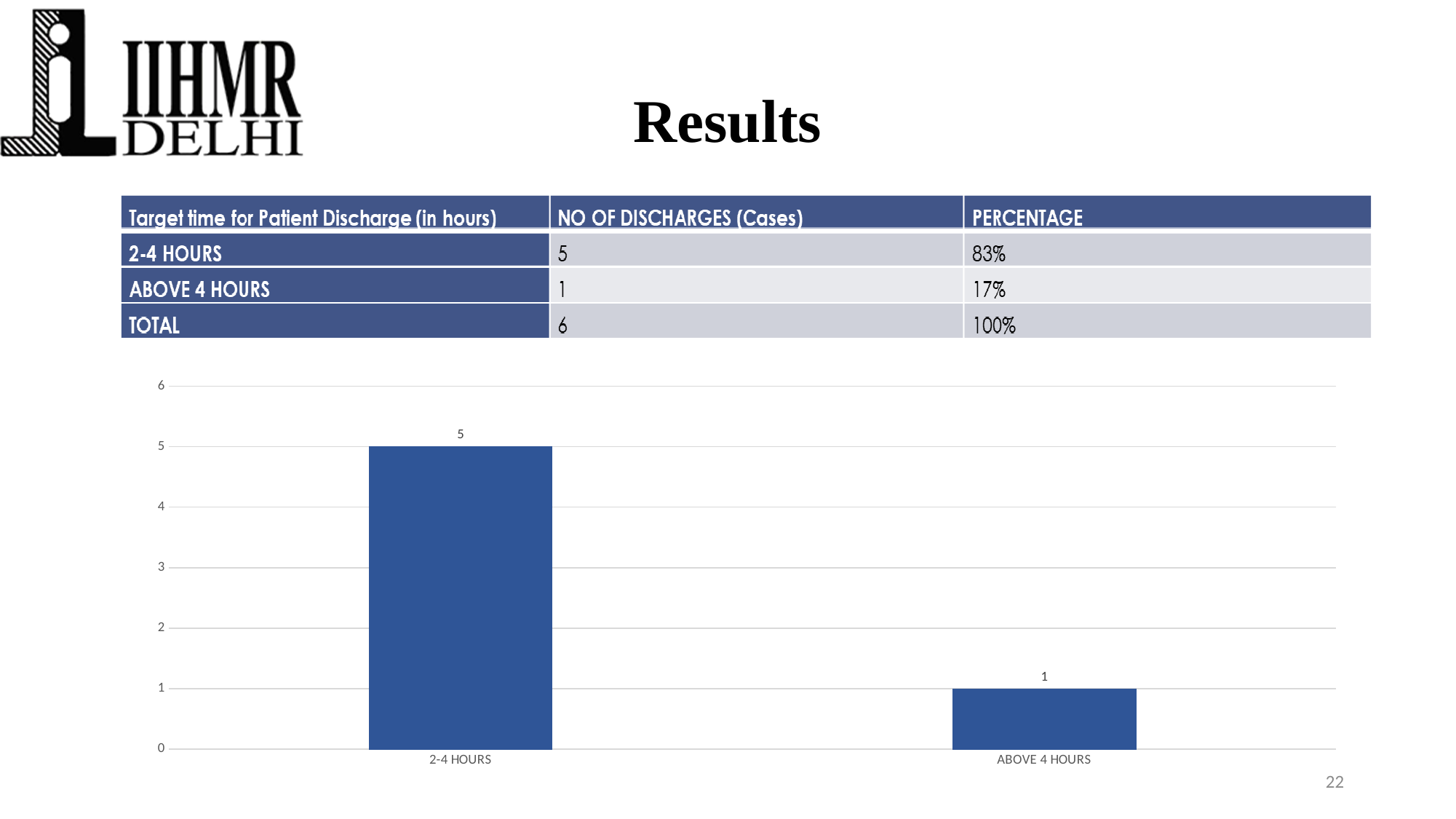
How many categories are shown on the x axis of the chart? 2 What is the value for 2-4 HOURS in the chart? 5 Which category has the lowest value in the chart? ABOVE 4 HOURS Which category has the highest value in the chart? 2-4 HOURS What kind of chart is shown on the slide? bar chart Which is larger, the value for 2-4 HOURS or the value for ABOVE 4 HOURS? 2-4 HOURS What is the difference between the values for 2-4 HOURS and ABOVE 4 HOURS? 4 Do the values rise or fall from left to right along the x axis? fall Is the value for 2-4 HOURS greater or less than 3? greater What is the value for ABOVE 4 HOURS in the chart? 1 Is the value for ABOVE 4 HOURS greater or less than 2? less What is the highest value shown on the chart's vertical axis? 6